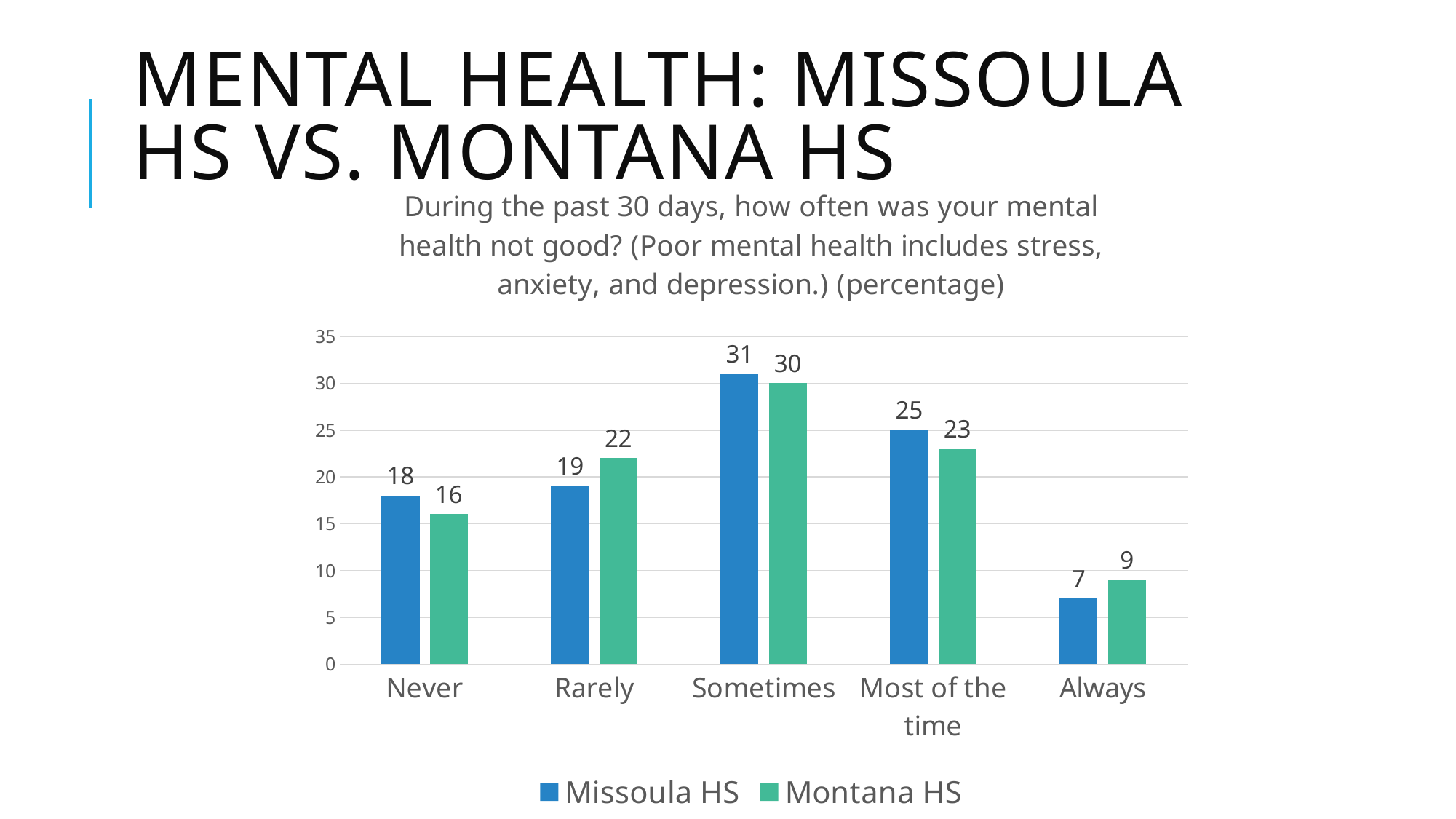
How many categories are shown on the x axis? 5 Which category has the highest value for Missoula HS? Sometimes Which series is shown in green in the legend? Montana HS What is the value for Missoula HS in the Sometimes category? 31 Which is larger in the Most of the time category, Missoula HS or Montana HS? Missoula HS What is the difference between Missoula HS and Montana HS in the Never category? 2 What is the difference between the Sometimes and Always values for Missoula HS? 24 What is the value for Montana HS in the Rarely category? 22 What kind of chart is shown on the slide? Bar chart What is the value for Montana HS in the Always category? 9 How many series does the legend list? 2 Which category has the lowest value for Montana HS? Always